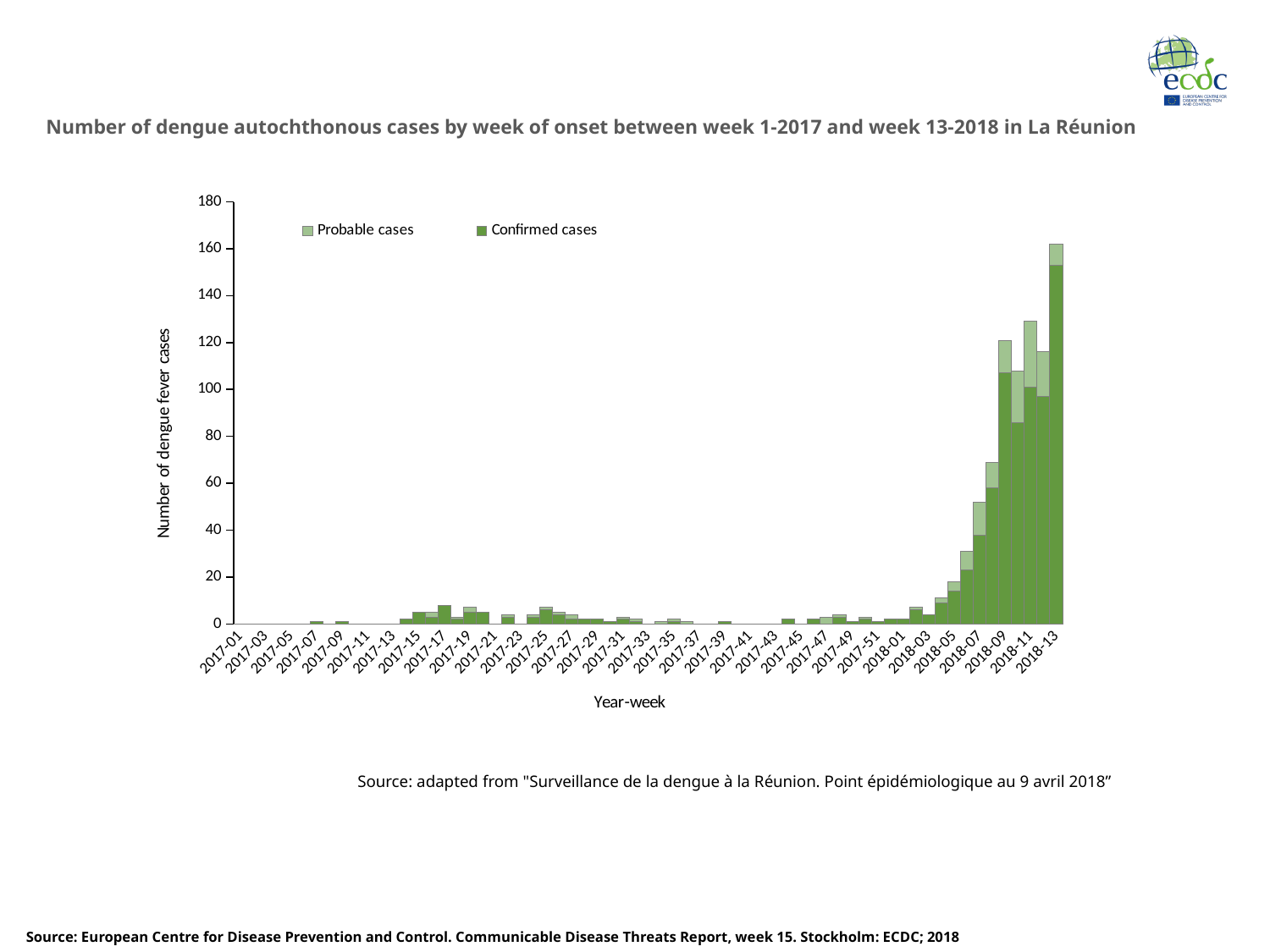
Which has more total cases, 2018-13 or 2018-11? 2018-13 What kind of chart is shown on the slide? Stacked bar chart What are the two series named in the legend? Probable cases and Confirmed cases What is the label of the y axis? Number of dengue fever cases Which year-week has the highest total number of cases? 2018-13 Do the number of cases rise or fall over the weeks from 2018-01 to 2018-13? rise Is the total number of cases for 2018-13 greater or less than 140? greater Which has more total cases, 2018-07 or 2018-05? 2018-07 Is the total number of cases for 2018-07 greater or less than 40? greater Is the total number of cases for 2018-09 greater or less than 100? greater How many series does the legend list? 2